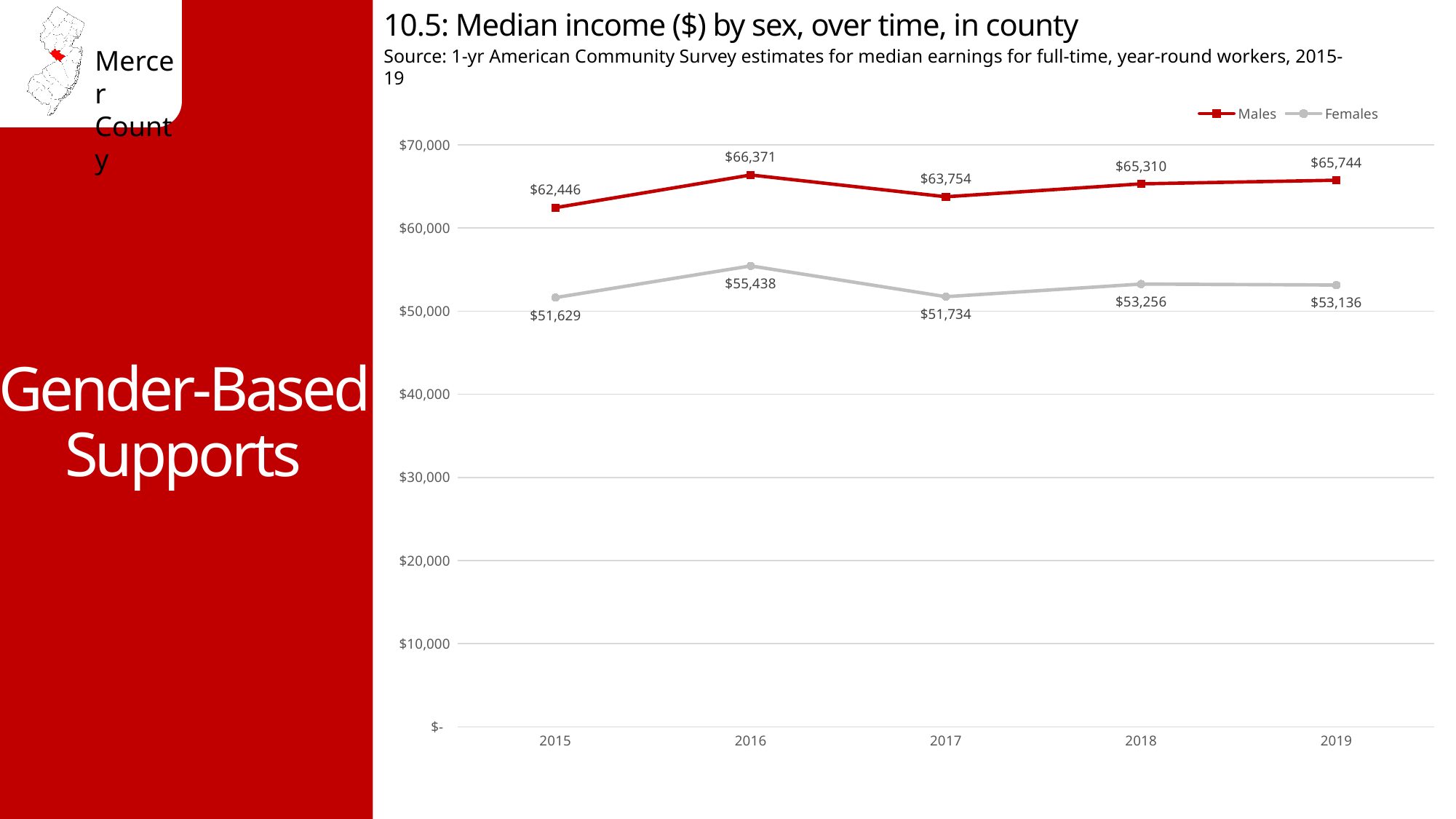
In which year was the median income for Males highest? 2016 How many series does the legend list? 2 What is the difference between the Males and Females median income in 2019? $12,608 What was the median income for Females in 2015? $51,629 Is the median income for Males in 2015 greater or less than $60,000? greater How many years are shown on the x axis? 5 What was the median income for Males in 2016? $66,371 What is the difference between the Males median income in 2016 and in 2017? $2,617 In which year was the median income for Females lowest? 2015 What was the median income for Females in 2019? $53,136 What kind of chart is shown on the slide? line chart Which is larger, the Females median income in 2018 or in 2019? 2018